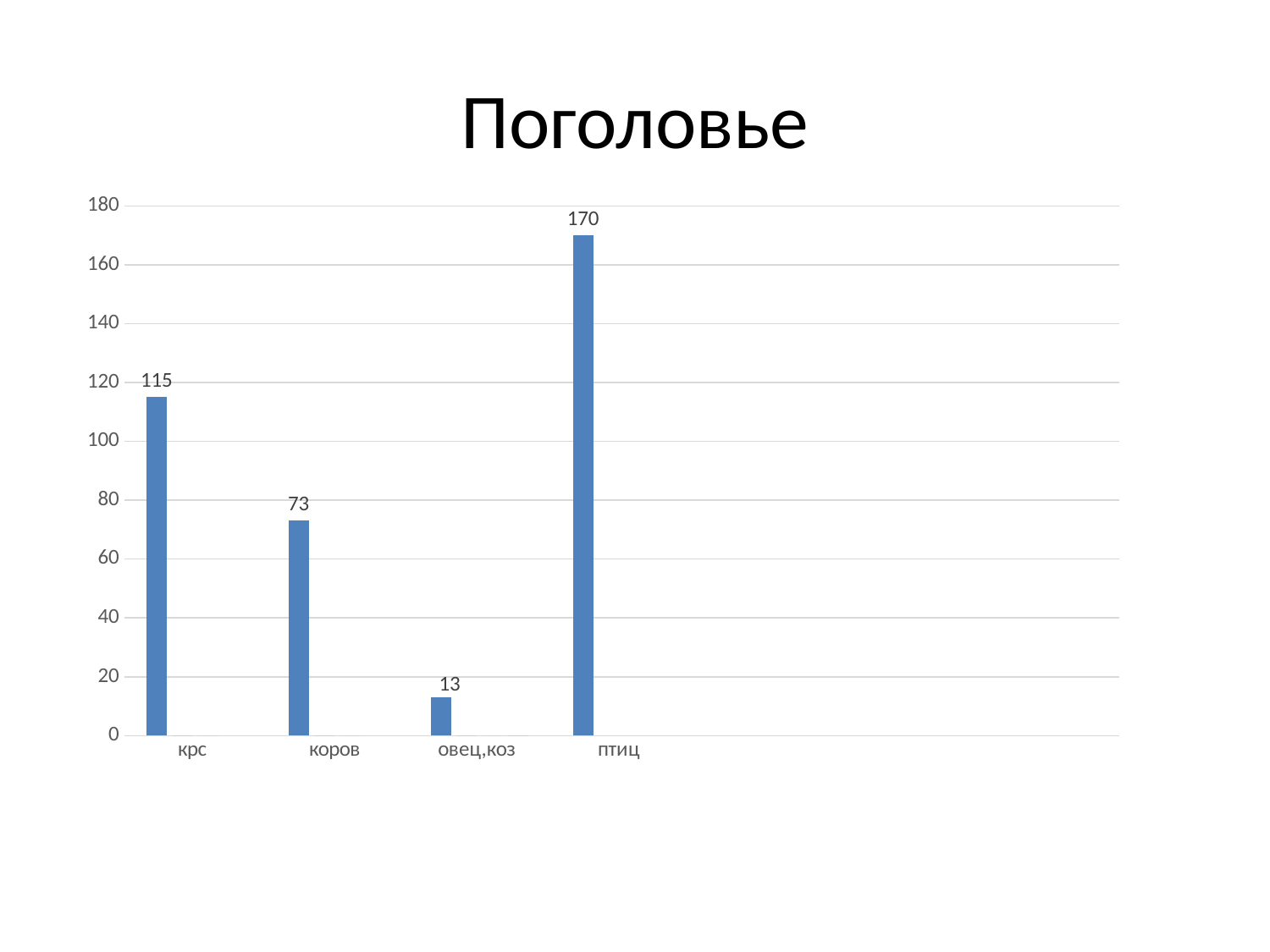
What is the value for овец,коз? 13 What is the value for коров? 73 Which category has the lowest value? овец,коз What is the difference between the values for коров and овец,коз? 60 How many categories are shown on the chart? 4 Is the value for коров greater or less than 80? less Which is larger, the value for крс or the value for коров? крс What kind of chart is shown on the slide? bar chart What is the value for крс? 115 What is the difference between the values for птиц and крс? 55 Which category has the highest value? птиц What is the value for птиц? 170